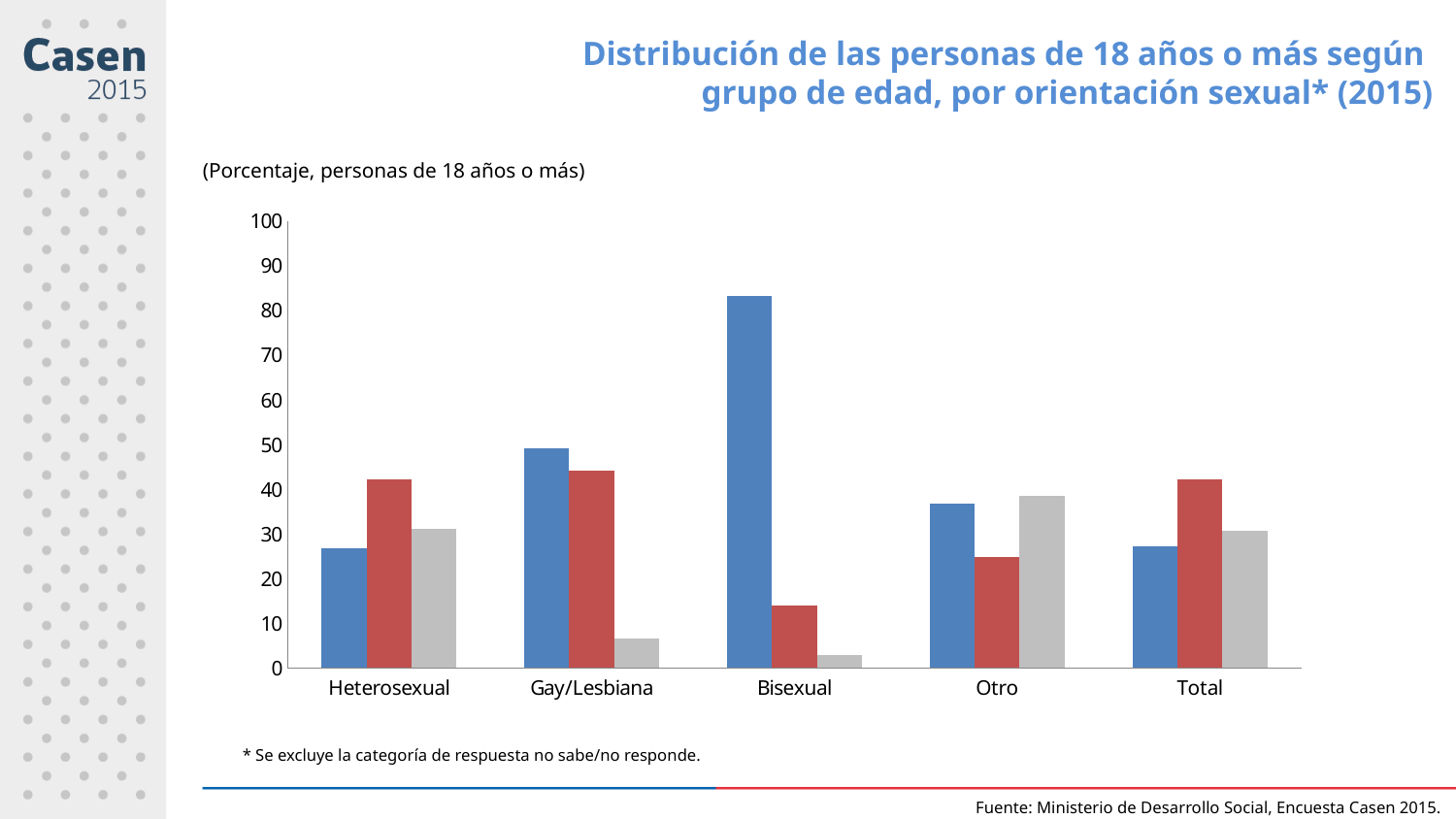
Is the blue bar for Bisexual greater or less than 80? greater Is the blue bar for Otro greater or less than 30? greater For Heterosexual, which is larger: the red bar or the blue bar? the red bar Which category has the shortest red bar? Bisexual For Bisexual, which is larger: the blue bar or the red bar? the blue bar What is the title of the chart on the slide? Distribución de las personas de 18 años o más según grupo de edad, por orientación sexual* (2015) Is the red bar for Heterosexual greater or less than 40? greater What kind of chart is shown on the slide? bar chart Which category has the tallest blue bar? Bisexual Which category has the shortest gray bar? Bisexual How many categories are shown on the x axis of the chart? 5